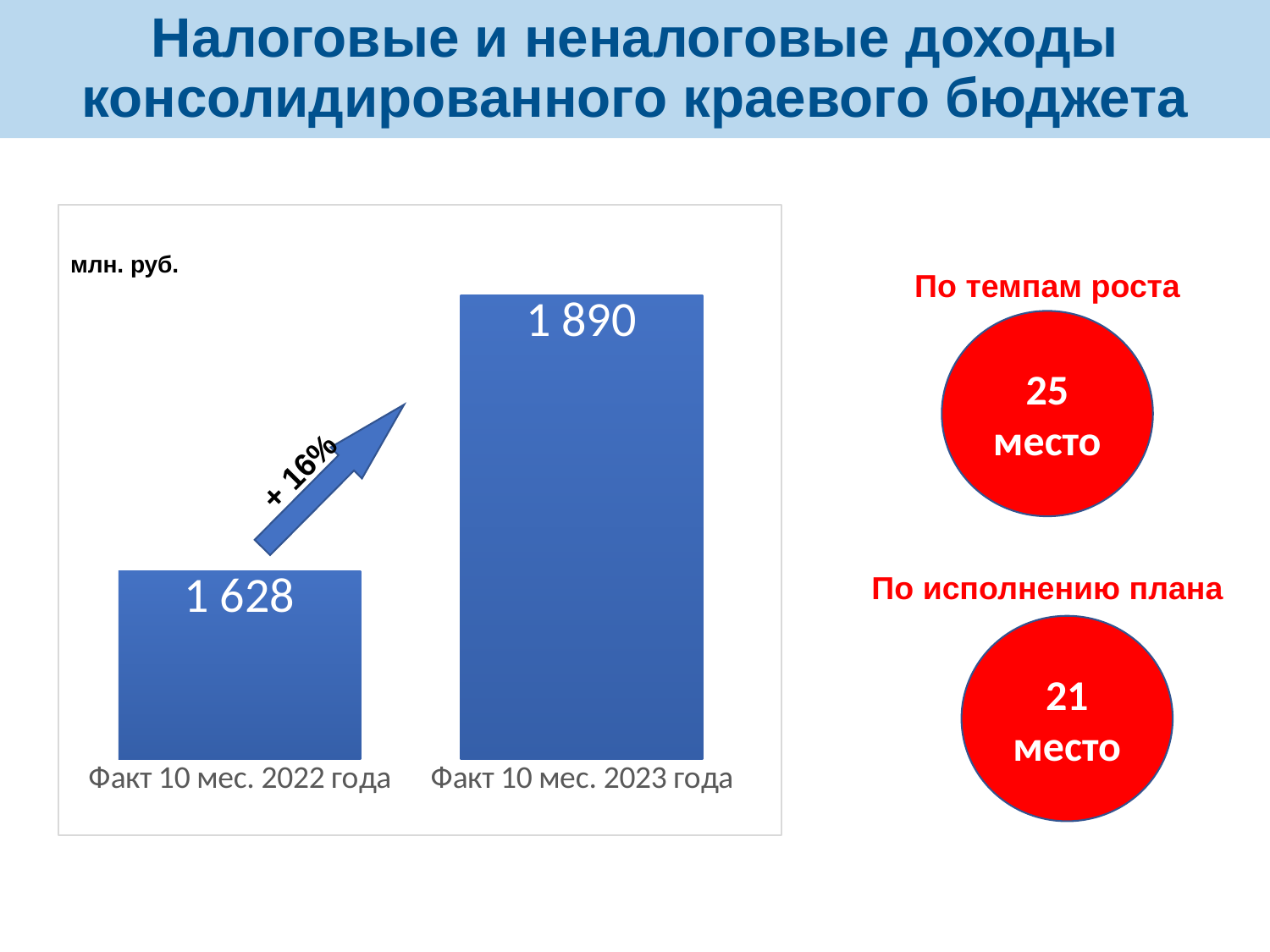
What unit of measurement is indicated on the chart? млн. руб. Which is larger: the value for Факт 10 мес. 2022 года or for Факт 10 мес. 2023 года? Факт 10 мес. 2023 года What kind of chart is shown on the slide? Bar chart What is the value for Факт 10 мес. 2022 года? 1 628 Do the values rise or fall from Факт 10 мес. 2022 года to Факт 10 мес. 2023 года? Rise Which category has the highest value? Факт 10 мес. 2023 года Which category has the lowest value? Факт 10 мес. 2022 года What is the difference between the values for Факт 10 мес. 2023 года and Факт 10 мес. 2022 года? 262 What percentage change is shown by the arrow between the two bars? + 16% What is the value for Факт 10 мес. 2023 года? 1 890 How many categories are shown in the chart? 2